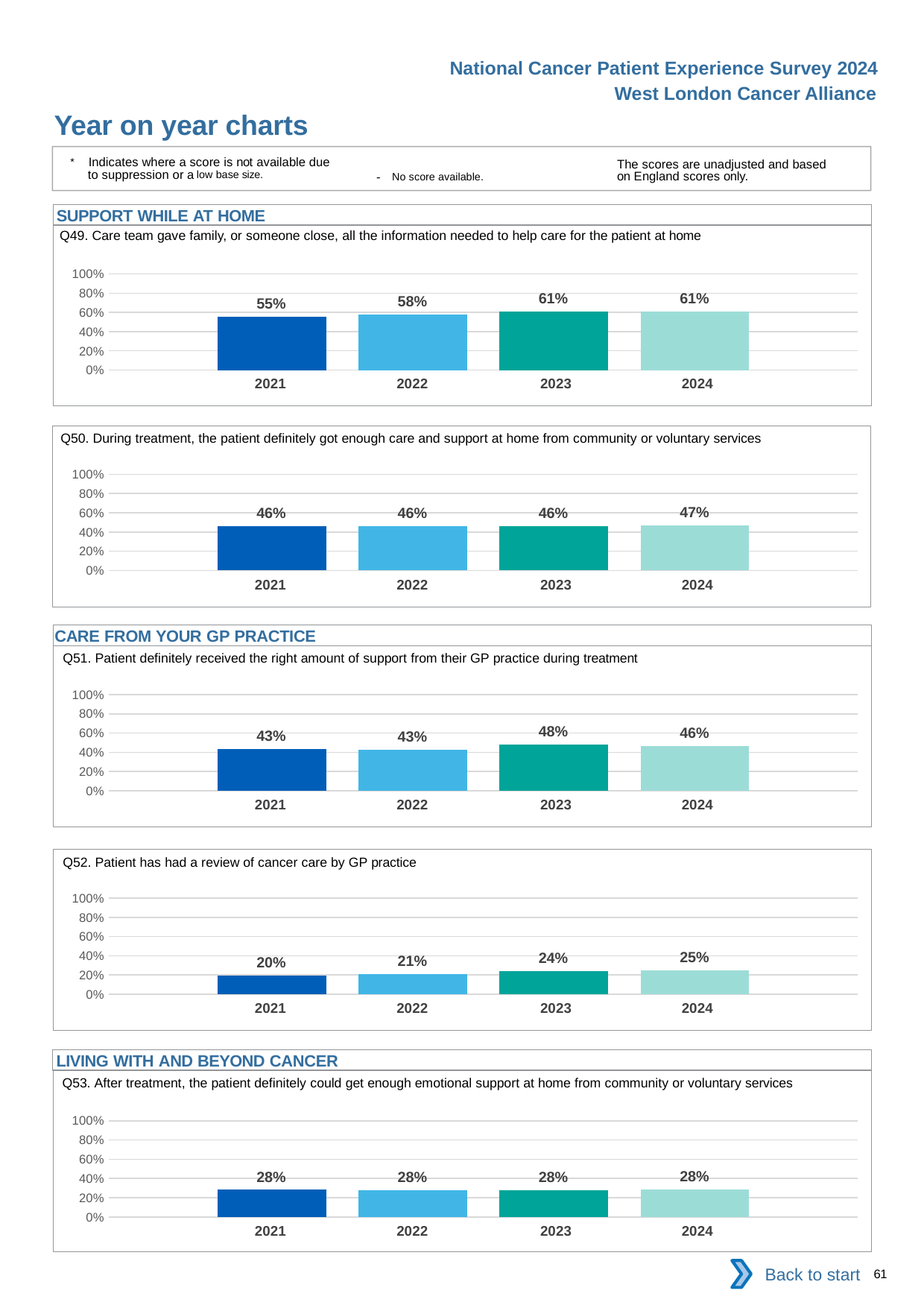
In the Q51 chart, what is the value for 2022? 43% In the Q49 chart, what is the value for 2021? 55% In the Q50 chart, how many years are plotted? 4 In the Q50 chart, what is the value for 2024? 47% In the Q51 chart, which year has the highest value? 2023 In the Q52 chart, what is the difference between the 2024 and 2021 values? 5% In the Q53 chart, what is the value for 2023? 28% In the Q52 chart, is the value for 2024 greater or less than 40%? less In the Q52 chart, which year has the lowest value? 2021 In the Q49 chart, what is the difference between the 2023 and 2021 values? 6% In the Q52 chart, do the values rise or fall from 2021 to 2024? rise What kind of chart is the Q53 chart? bar chart